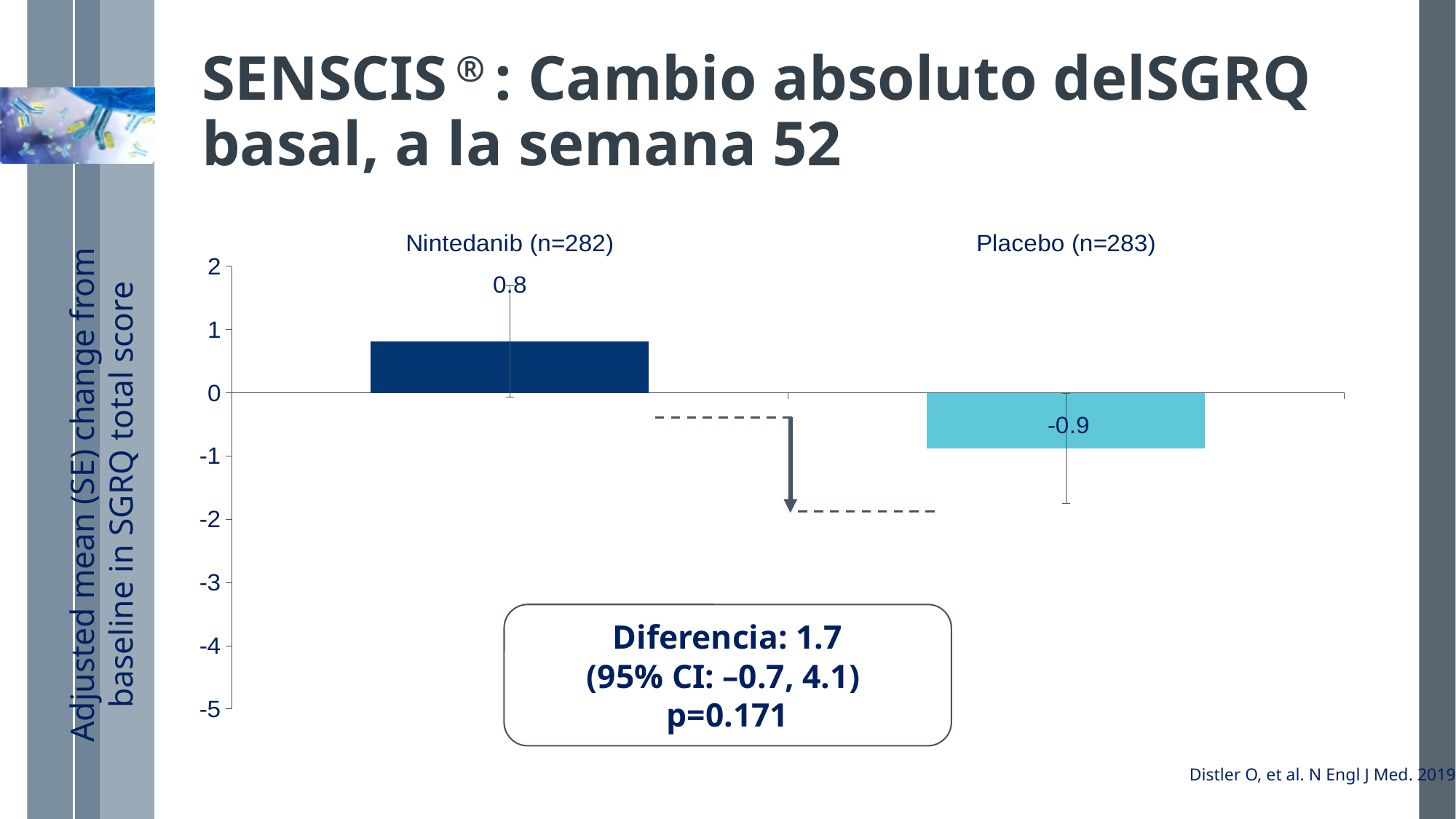
What p-value is shown in the box on the chart? p=0.171 Is the value for Placebo greater or less than -1? greater What is the y-axis label of the chart? Adjusted mean (SE) change from baseline in SGRQ total score Is the Nintedanib value larger or smaller than the Placebo value? larger What is the adjusted mean change in SGRQ total score for Nintedanib (n=282)? 0.8 Which group has the higher adjusted mean change in SGRQ total score? Nintedanib (n=282) What is the difference between the Nintedanib value and the Placebo value? 1.7 What is the adjusted mean change in SGRQ total score for Placebo (n=283)? -0.9 Which group has the lower adjusted mean change in SGRQ total score? Placebo (n=283) How many groups are plotted in the chart? 2 Is the value for Nintedanib greater or less than 1? less What kind of chart is shown on the slide? bar chart